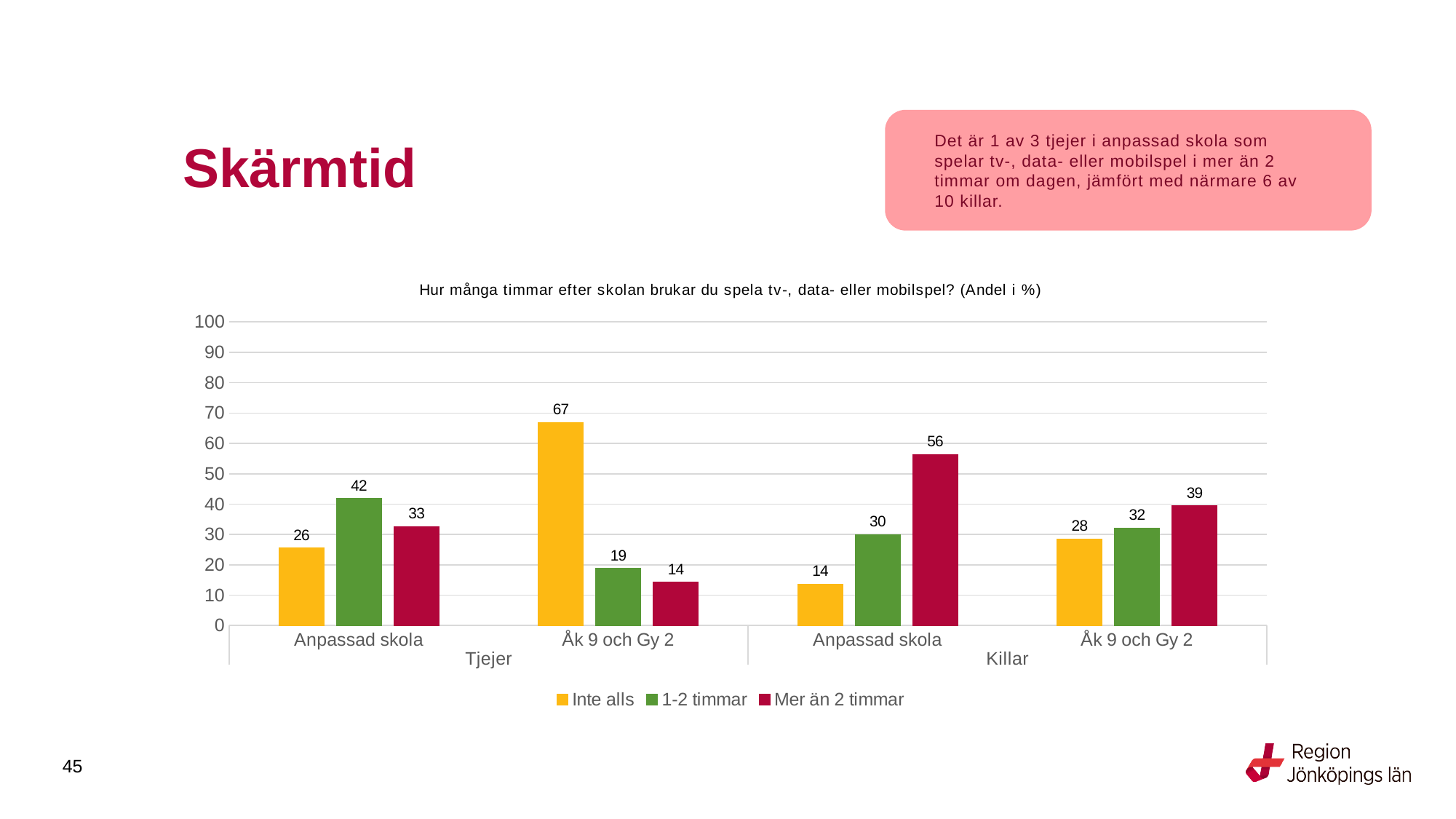
What is the difference between "Mer än 2 timmar" for Anpassad skola among Killar and among Tjejer? 23 Which colour represents "Mer än 2 timmar" in the legend? Dark red Which group has the lowest value for "Mer än 2 timmar"? Åk 9 och Gy 2 (Tjejer) What is the value for "Inte alls" for Åk 9 och Gy 2 among Tjejer? 67 Which group has the highest value for "Inte alls"? Åk 9 och Gy 2 (Tjejer) What is the total of the three values for Åk 9 och Gy 2 among Tjejer? 100 What is the value for "Mer än 2 timmar" for Anpassad skola among Killar? 56 What is the value for "1-2 timmar" for Åk 9 och Gy 2 among Killar? 32 What kind of chart is shown on the slide? Bar chart What is the value for "Mer än 2 timmar" for Anpassad skola among Tjejer? 33 How many series does the legend list? 3 Which is larger: "1-2 timmar" for Anpassad skola among Tjejer or "1-2 timmar" for Anpassad skola among Killar? Anpassad skola among Tjejer